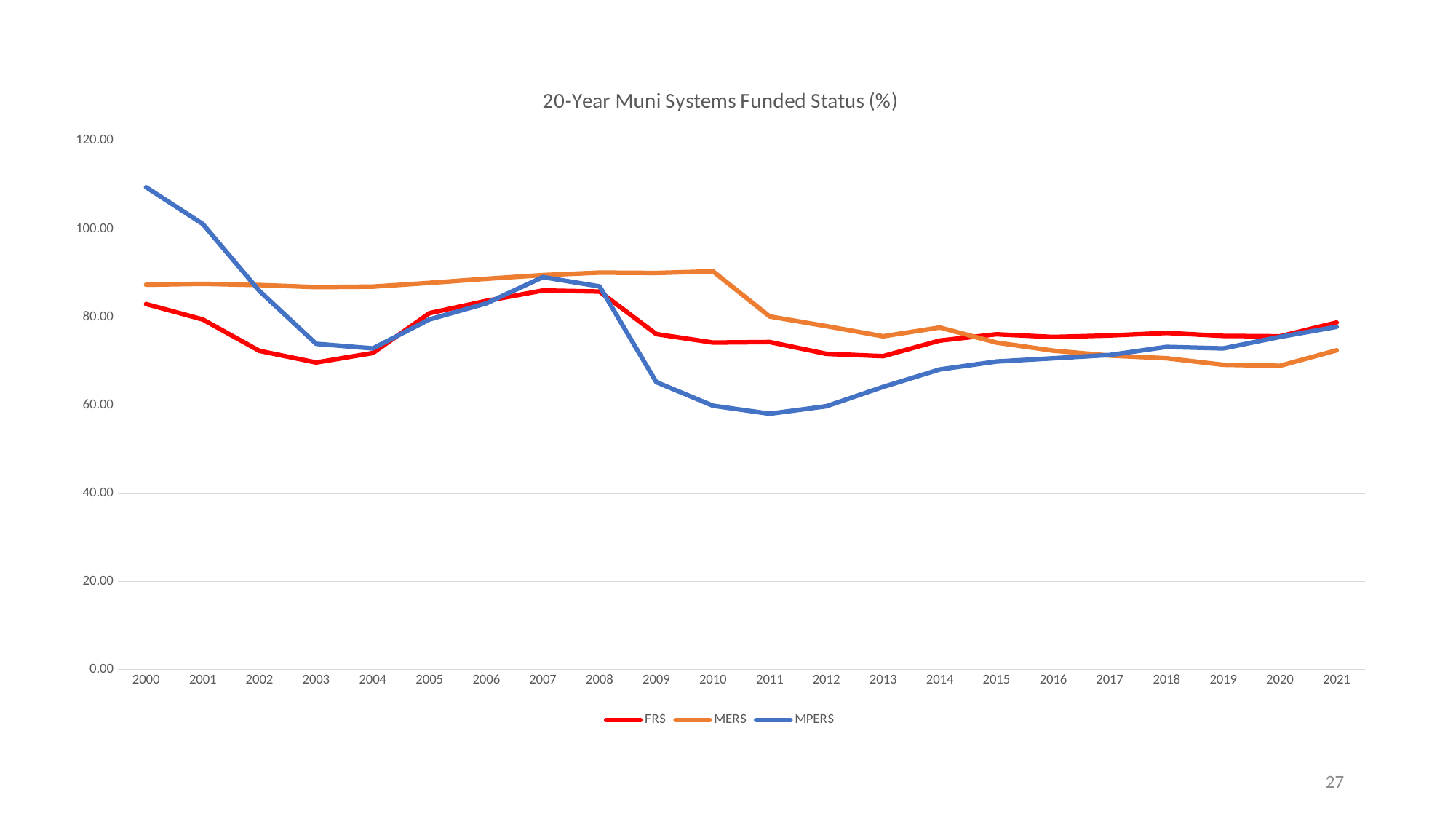
Which series has the highest value in 2000? MPERS How many years are plotted along the x axis? 22 Which series is drawn in blue? MPERS Is the value for FRS in 2003 greater or less than 80? less How many series does the legend list? 3 What kind of chart is shown on the slide? Line chart In which year does MPERS reach its lowest value? 2011 In 2010, which is larger, MERS or MPERS? MERS Is the value for MPERS in 2011 greater or less than 60? less Does the MPERS line rise or fall from 2000 to 2003? Fall Is the value for MPERS in 2000 greater or less than 100? greater What is the title of the chart? 20-Year Muni Systems Funded Status (%)